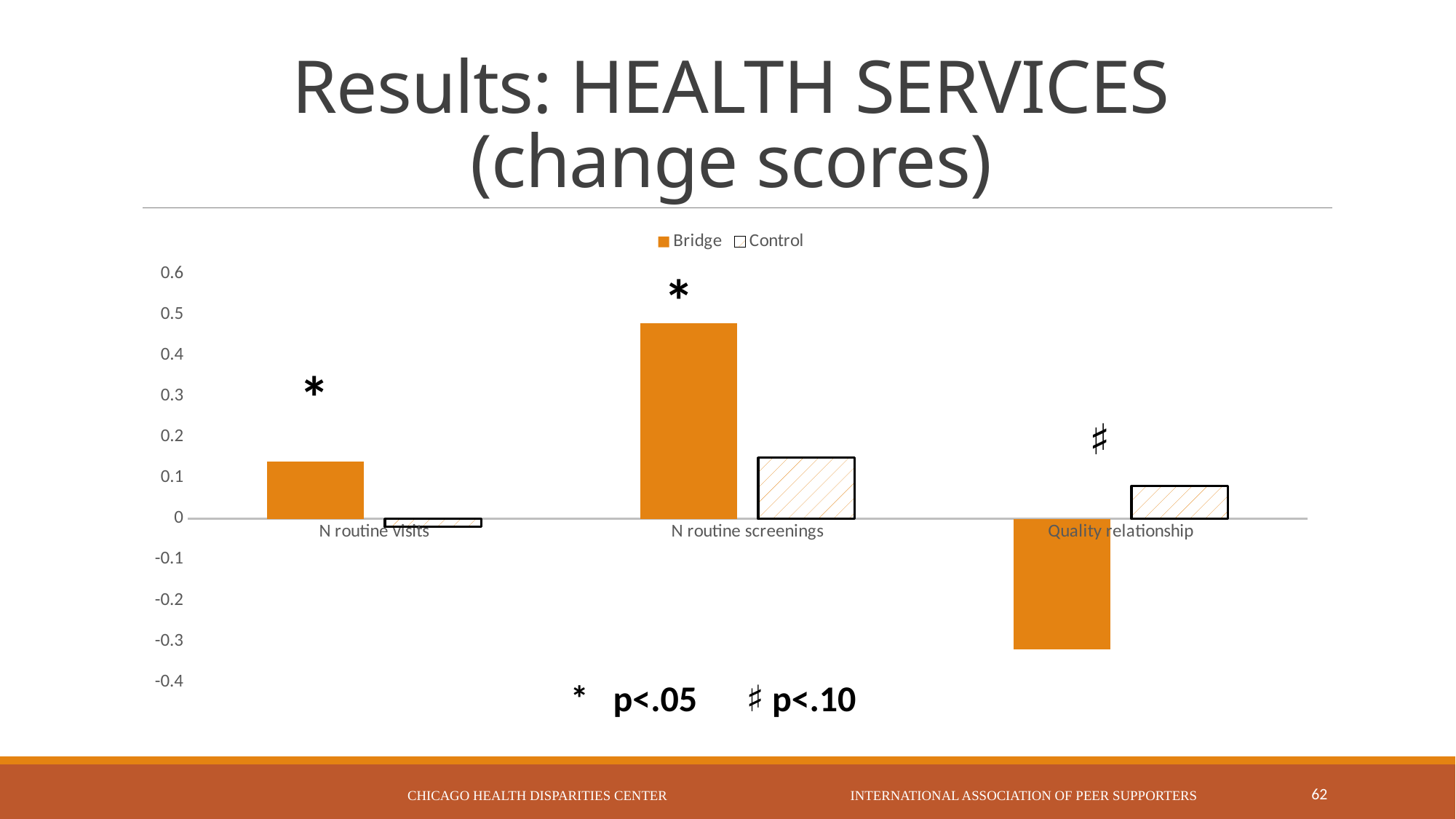
For which category is the Bridge value lowest? Quality relationship Is the Bridge value for Quality relationship greater or less than -0.2? less For which category is the Bridge value highest? N routine screenings How many series does the chart's legend list? 2 What kind of chart is shown on the slide? bar chart Is the Bridge value for N routine visits greater or less than 0.1? greater For which category is the Control value highest? N routine screenings Is the Bridge value for N routine screenings greater or less than 0.4? greater For N routine screenings, which series has the larger value, Bridge or Control? Bridge How many categories are shown on the x axis of the chart? 3 Which series are listed in the chart's legend? Bridge and Control For Quality relationship, which series has the larger value, Bridge or Control? Control